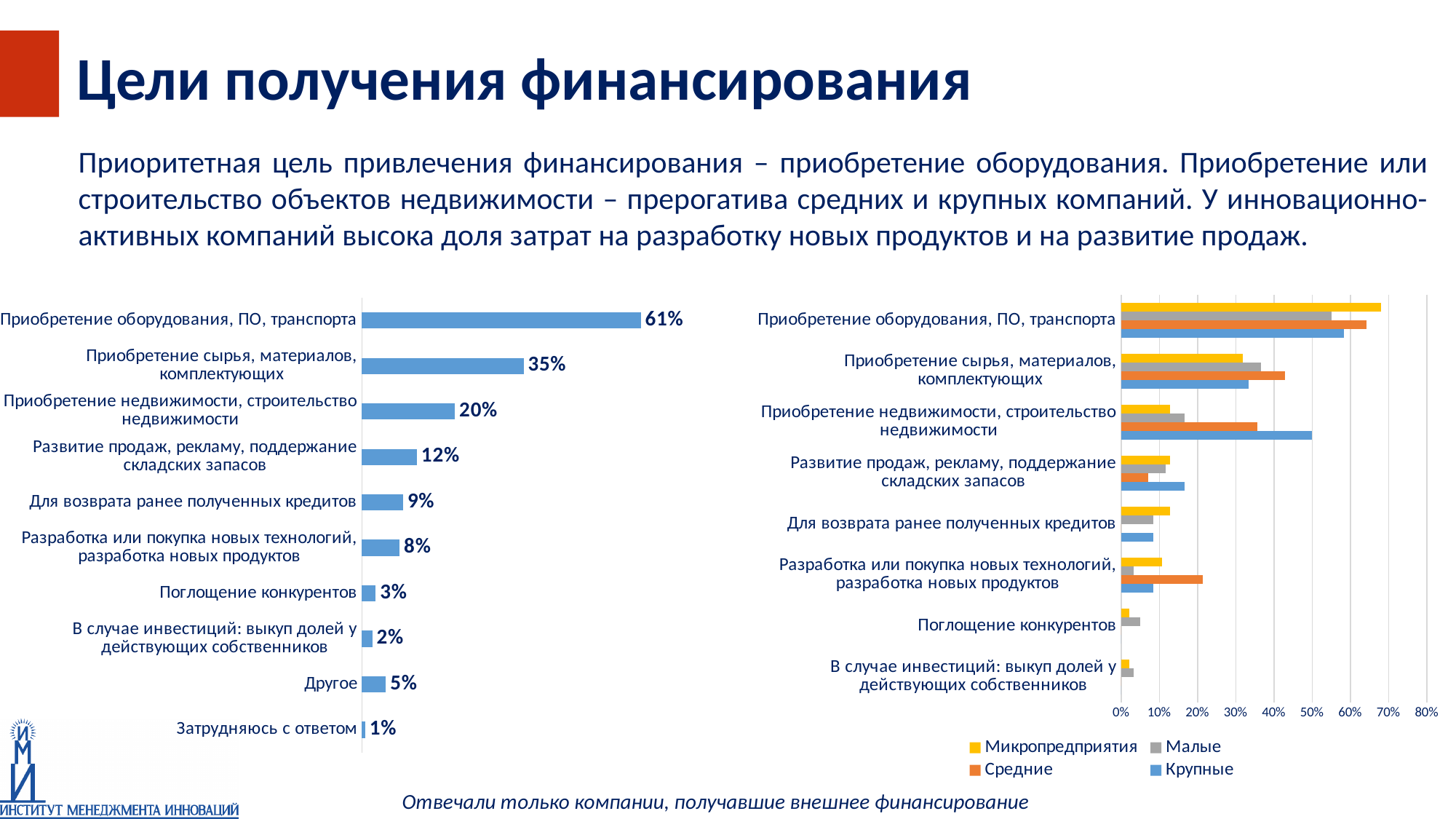
In the left chart, what is the value for «Приобретение оборудования, ПО, транспорта»? 61% In the left chart, which category has the lowest value? Затрудняюсь с ответом How many series does the legend of the right chart list? 4 In the left chart, what is the value for «Поглощение конкурентов»? 3% In the right chart, for «Приобретение недвижимости, строительство недвижимости», which series has the larger value: «Крупные» or «Микропредприятия»? Крупные In the right chart, is the value of «Микропредприятия» for «Приобретение оборудования, ПО, транспорта» greater or less than 60%? greater In the left chart, what is the value for «Приобретение сырья, материалов, комплектующих»? 35% What type of chart is the left chart? Bar chart In the left chart, what is the difference between «Приобретение оборудования, ПО, транспорта» and «Приобретение сырья, материалов, комплектующих»? 26 percentage points In the left chart, which category has the highest value? Приобретение оборудования, ПО, транспорта In the left chart, which is larger: «Другое» or «Поглощение конкурентов»? Другое How many categories does the left chart show? 10